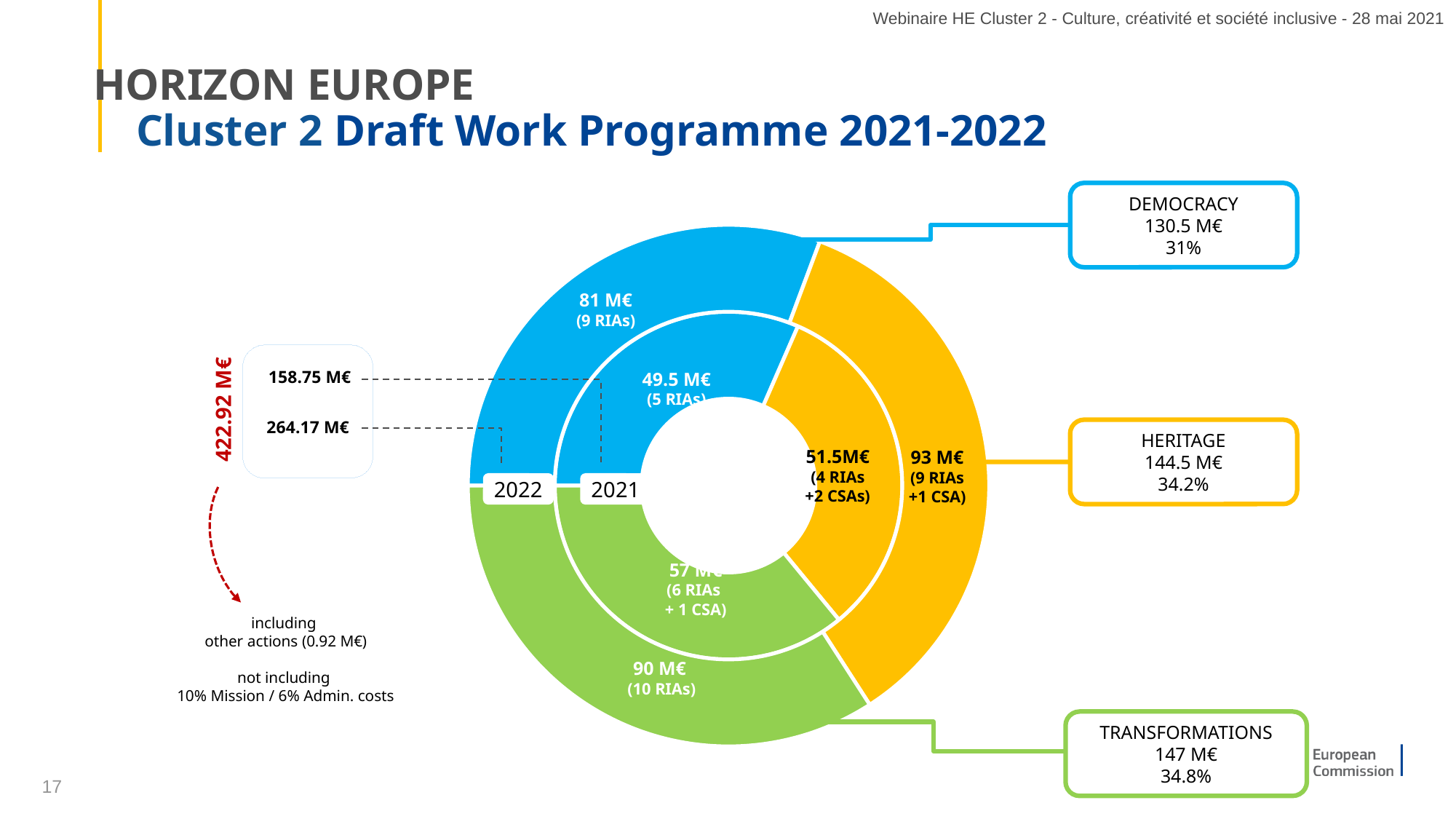
How many categories are shown in the doughnut chart? 3 What share of the total does Transformations represent? 34.8% Which category has the highest 2022 value? Heritage What is the 2021 value for Heritage in the inner ring? 51.5M€ Which is larger, the 2021 value for Transformations or the 2021 value for Democracy? Transformations What kind of chart is shown on the slide? doughnut chart What is the difference between the 2022 and 2021 values for Democracy? 31.5 M€ What is the total amount shown for the 2022 ring? 264.17 M€ What is the 2022 value for Transformations? 90 M€ What is the 2022 value for Democracy in the outer ring? 81 M€ What is the total amount shown for Heritage across both years? 144.5 M€ Which category has the lowest total amount? Democracy